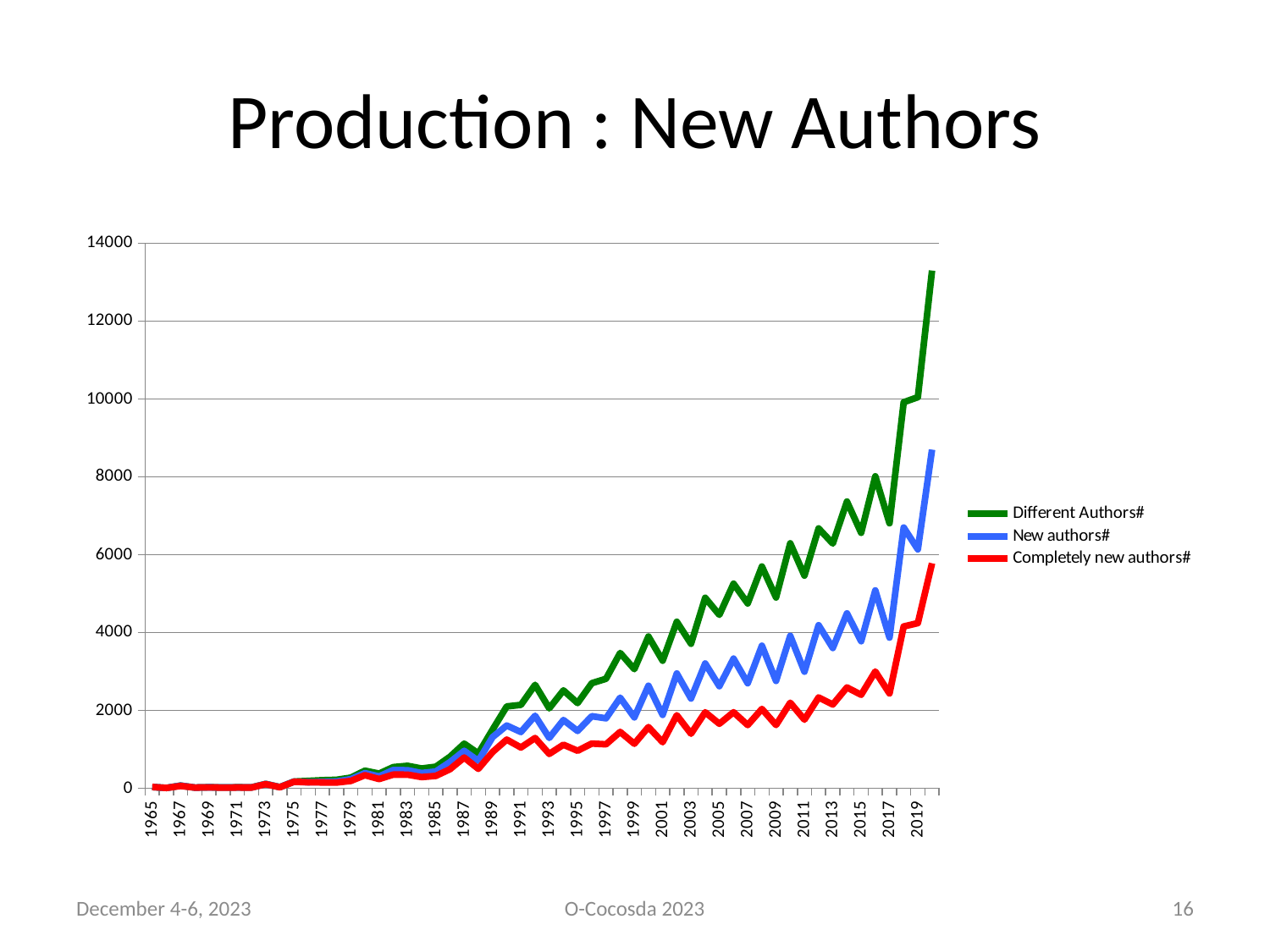
Is the value for Different Authors# in 1965 greater or less than 2000? less What is the title of the chart on the slide? Production : New Authors Which series has the lowest values at the right end of the chart? Completely new authors# Is the final value for New authors# greater or less than 8000? greater How many series does the legend list? 3 Is the final value for Different Authors# greater or less than 12000? greater At the right end of the chart, which is larger: Different Authors# or Completely new authors#? Different Authors# Which series reaches the highest value at the right end of the chart? Different Authors# Do the values for Different Authors# generally rise or fall from 1965 to the end of the x axis? rise Which series is drawn in green in the chart? Different Authors# What kind of chart is shown on the slide? line chart